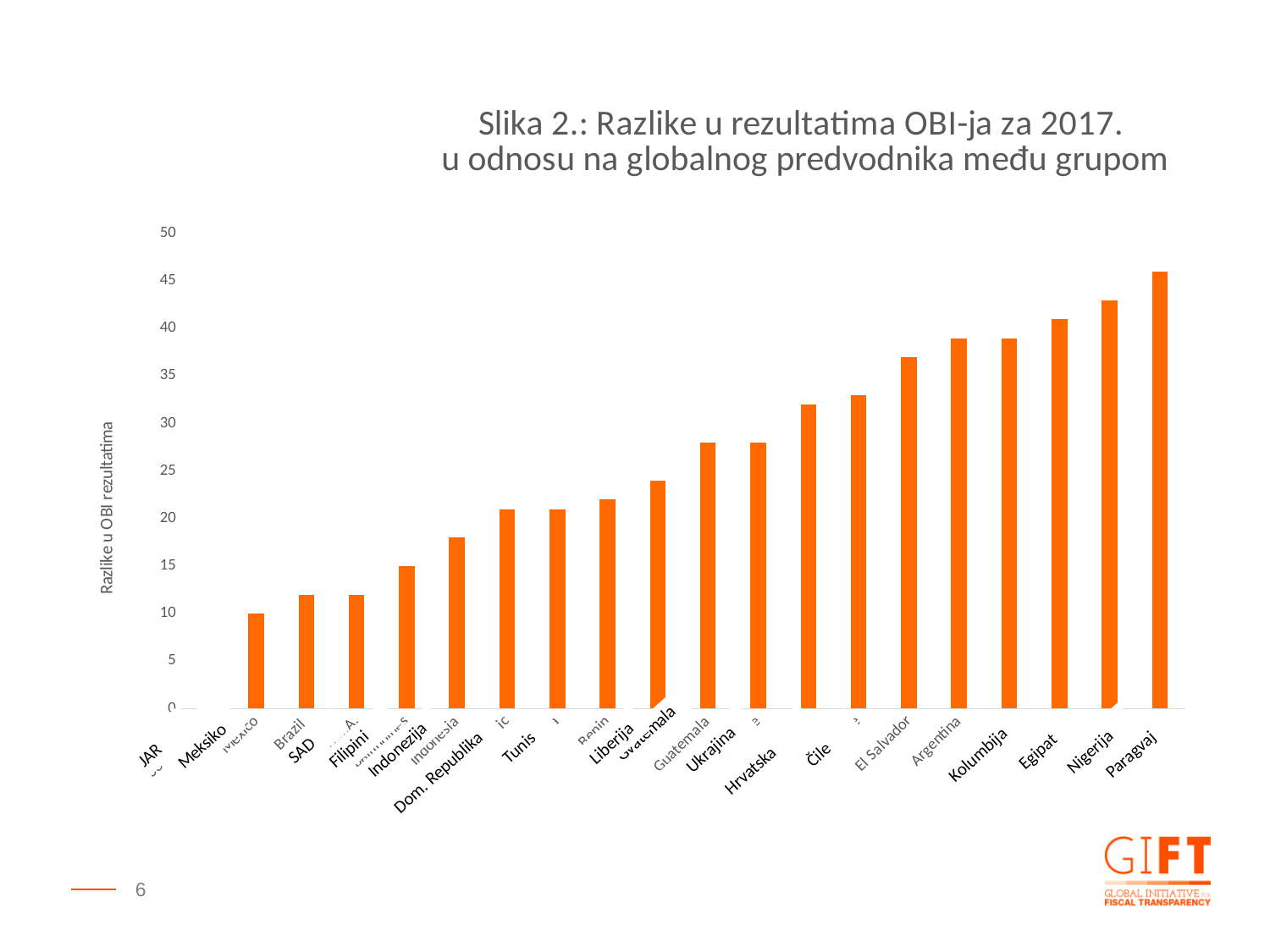
Is the value for JAR greater or less than 15? less Which is larger, the value for Nigerija or the value for Paragvaj? Paragvaj Which country has the highest value in the chart? Paragvaj Is the value for Paragvaj greater or less than 40? greater What kind of chart is shown on the slide? bar chart Do the values rise or fall moving from left to right along the x axis? rise Which country has the lowest value in the chart? JAR What is the label of the vertical axis? Razlike u OBI rezultatima Is the value for Meksiko greater or less than 15? less Which is larger, the value for Paragvaj or the value for JAR? Paragvaj What is the title of the chart? Slika 2.: Razlike u rezultatima OBI-ja za 2017. u odnosu na globalnog predvodnika među grupom